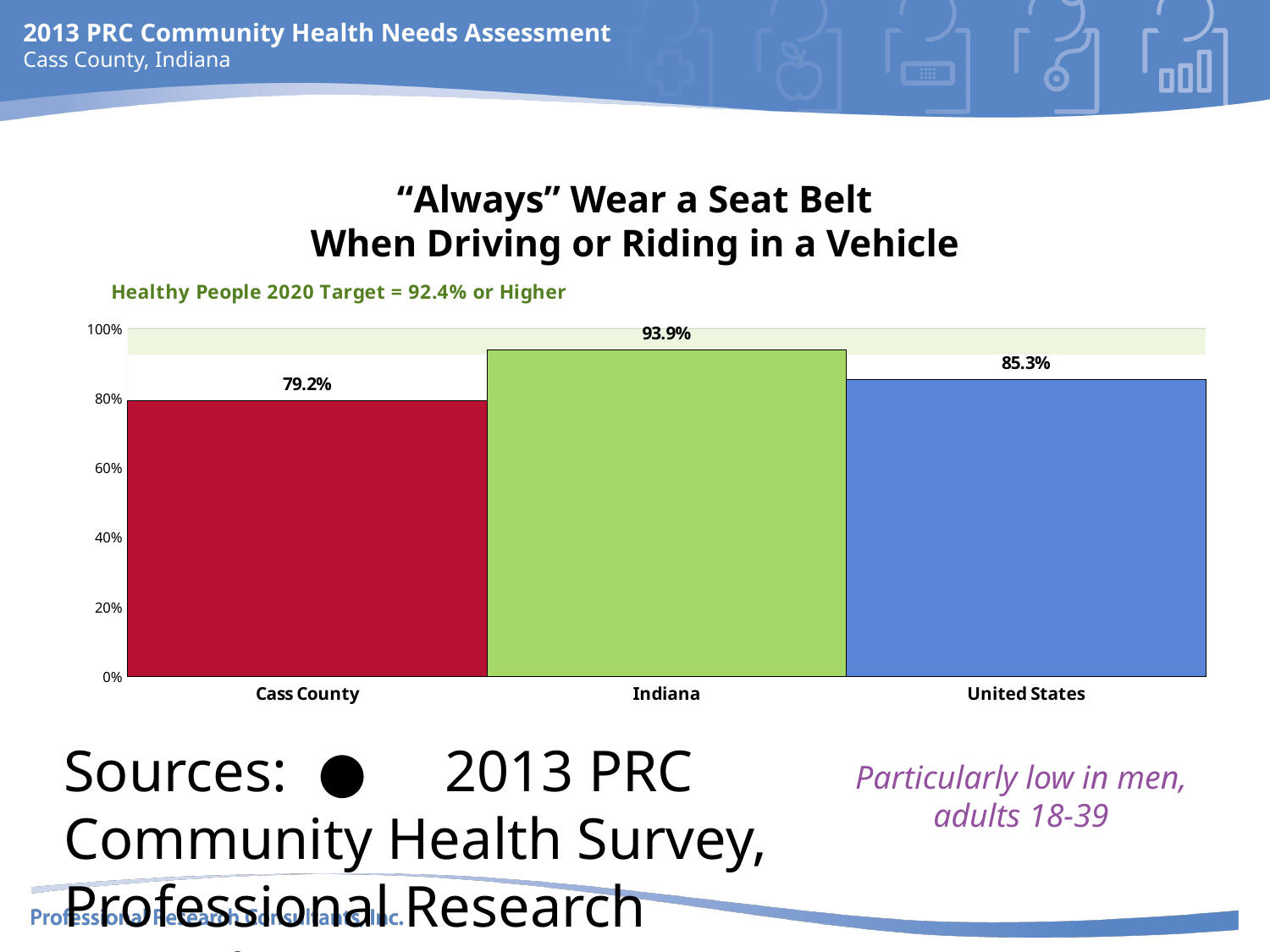
What is the difference between the values for United States and Cass County? 6.1% What kind of chart is shown on the slide? bar chart Is the value for Cass County greater or less than 80%? less What is the value for United States? 85.3% Which category has the lowest value? Cass County Which category has the highest value? Indiana How many categories are shown on the chart? 3 Which is larger, the value for United States or the value for Cass County? United States What is the value for Cass County? 79.2% What is the Healthy People 2020 Target stated above the chart? 92.4% or Higher What is the value for Indiana? 93.9% What is the difference between the values for Indiana and Cass County? 14.7%